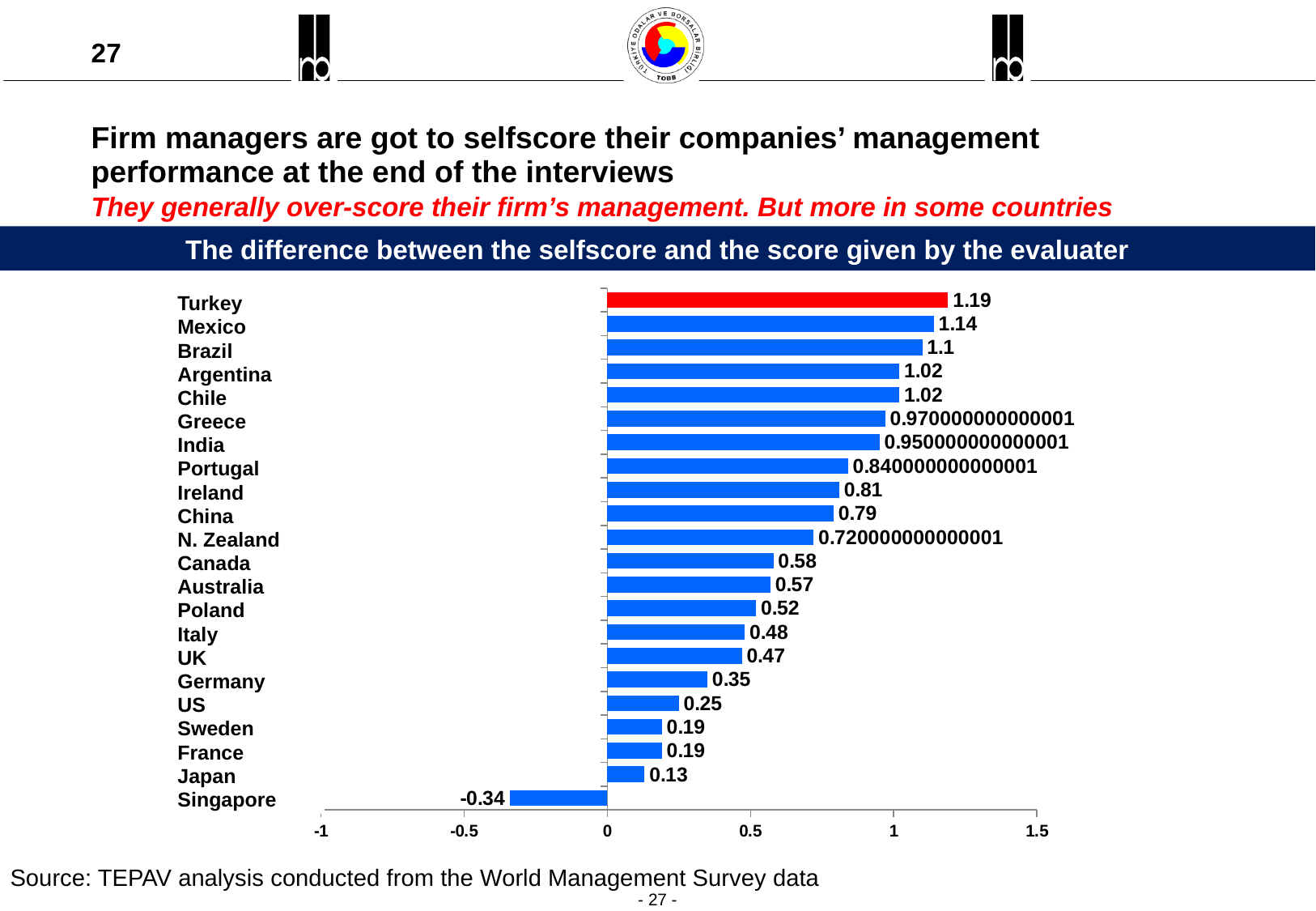
What is the difference between the values for Germany and US? 0.1 What is the value for Japan? 0.13 What is the value for Germany? 0.35 What is the value for Singapore? -0.34 How many countries are shown in the chart? 22 Which has a larger value, Ireland or Canada? Ireland Which country has the highest value? Turkey What is the difference between the values for Turkey and Mexico? 0.05 Is the value for Brazil greater or less than 1? greater What type of chart is shown on the slide? Bar chart What is the value for Turkey? 1.19 Which country has the lowest value? Singapore